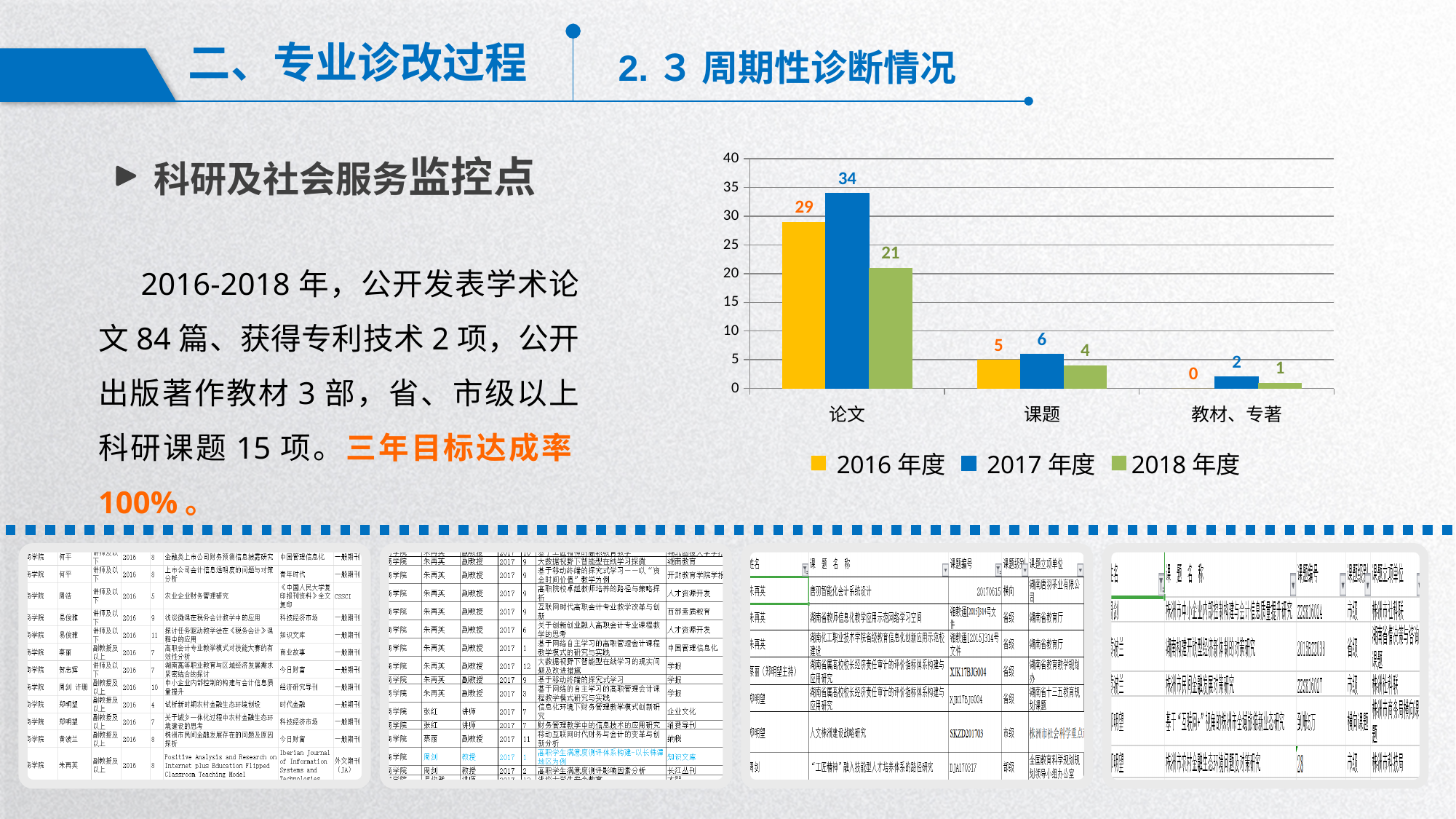
What is the value for 教材、专著 in the 2018 年度 series? 1 What is the difference between the 2017 年度 and 2016 年度 values for 论文? 5 What is the value for 论文 in the 2017 年度 series? 34 What is the total of the three series values for 教材、专著? 3 How many categories are shown on the x axis of the chart? 3 What is the value for 课题 in the 2016 年度 series? 5 What kind of chart is shown on the slide? bar chart How many series does the chart legend list? 3 Which category has the lowest value in the 2016 年度 series? 教材、专著 Is the 2016 年度 value for 论文 greater or less than 25? greater Which is larger for 课题: the 2017 年度 value or the 2018 年度 value? 2017 年度 Which category has the highest value in the 2018 年度 series? 论文